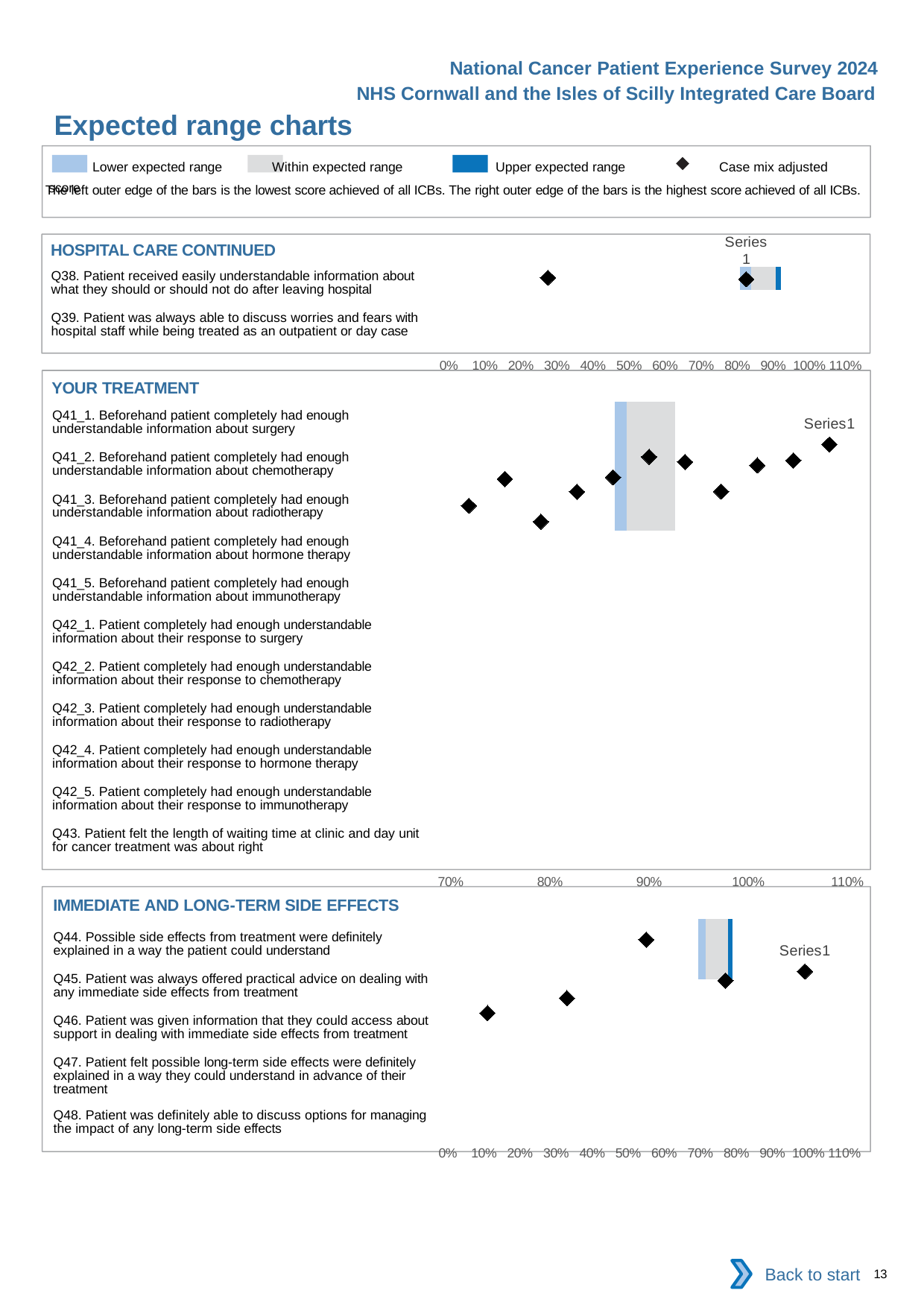
How many diamond markers are plotted in the IMMEDIATE AND LONG-TERM SIDE EFFECTS chart? 5 How many diamond markers are plotted in the YOUR TREATMENT chart? 11 What is the name of the series shown in the legend of the IMMEDIATE AND LONG-TERM SIDE EFFECTS chart? Series1 How many series does the legend of the YOUR TREATMENT chart list? 1 How many diamond markers are plotted in the HOSPITAL CARE CONTINUED chart? 2 Which chart on the slide has the most plotted diamond markers? YOUR TREATMENT Which chart on the slide has the fewest plotted diamond markers? HOSPITAL CARE CONTINUED How many series does the legend of the HOSPITAL CARE CONTINUED chart list? 1 According to the legend at the top of the slide, what does the diamond marker represent? Case mix adjusted score